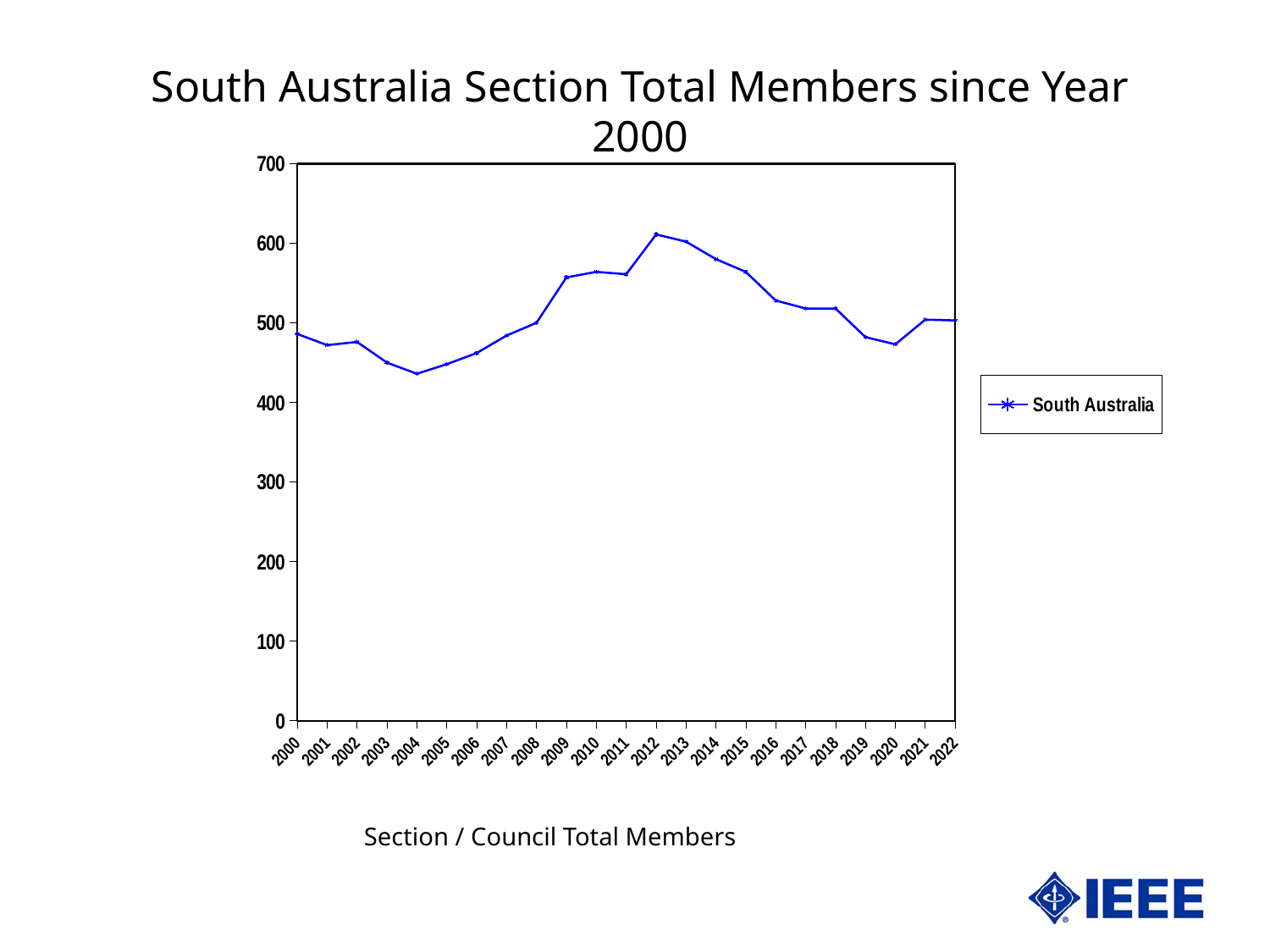
What kind of chart is shown on the slide? line chart How many years are plotted along the x axis? 23 Do the values rise or fall from 2012 to 2020? fall Which year has more members, 2014 or 2019? 2014 In which year is the number of South Australia members highest? 2012 Do the values rise or fall from 2004 to 2012? rise Is the value for 2012 greater or less than 600? greater What is the name of the series shown in the legend? South Australia Is the value for 2009 greater or less than 500? greater In which year is the number of South Australia members lowest? 2004 How many series does the legend list? 1 Is the value for 2004 greater or less than 500? less